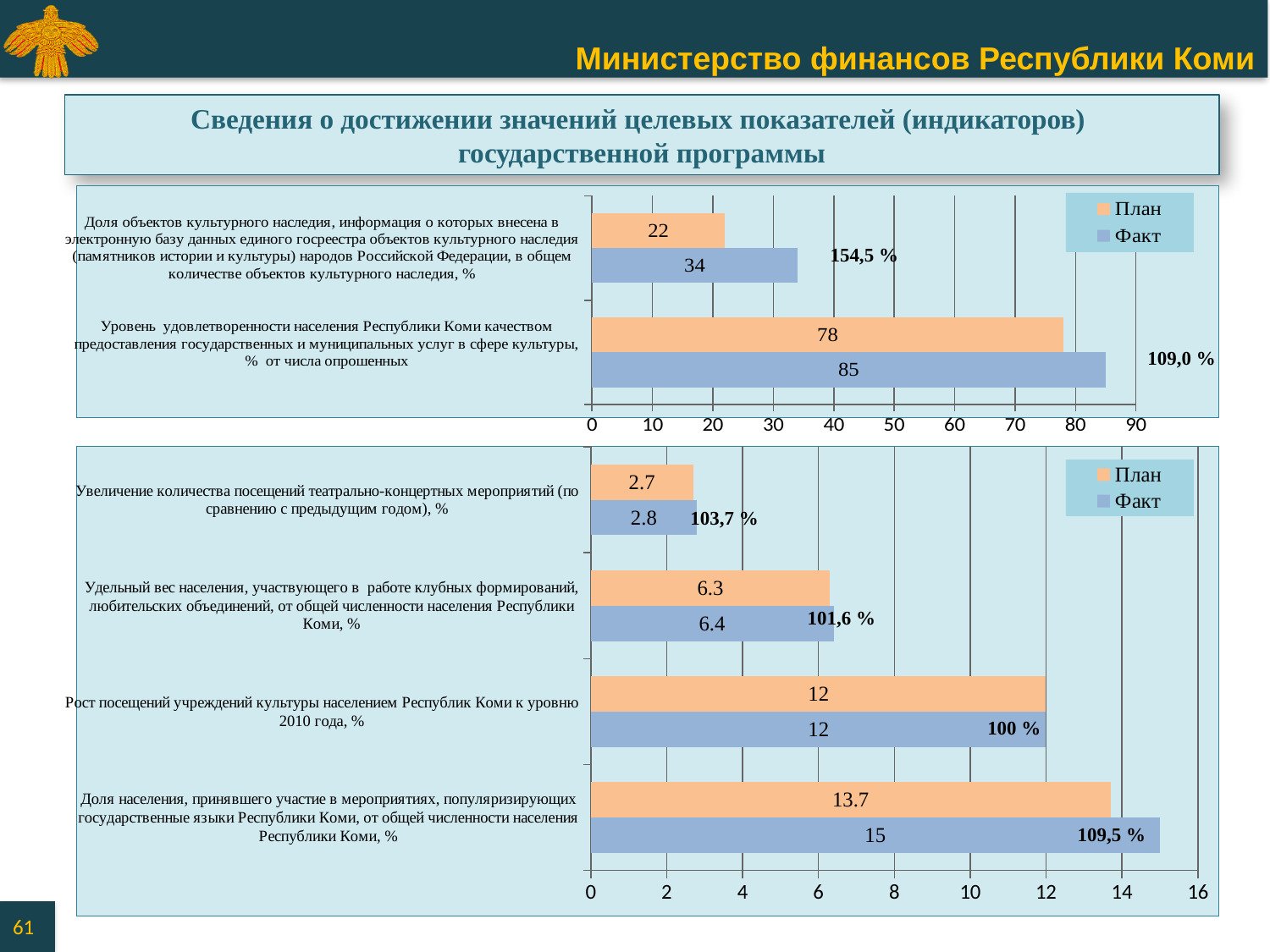
In the bottom chart, how many categories are plotted? 4 In the bottom chart, what is the План value for the increase in attendance of theatre and concert events (Увеличение количества посещений театрально-концертных мероприятий)? 2.7 In the top chart, what is the План value for the share of cultural heritage objects entered in the electronic database (Доля объектов культурного наследия...)? 22 In the bottom chart, what is the difference between the Факт and План values for the share of population participating in events popularizing the state languages (Доля населения, принявшего участие...)? 1.3 In the top chart, what is the difference between the Факт and План values for the level of population satisfaction (Уровень удовлетворенности населения...)? 7 In the top chart, what is the Факт value for the level of population satisfaction with the quality of cultural services (Уровень удовлетворенности населения...)? 85 In the top chart, how many series does the legend list? 2 In the bottom chart, which category has the highest Факт value? Доля населения, принявшего участие в мероприятиях, популяризирующих государственные языки Республики Коми In the top chart, which series is shown in orange according to the legend? План In the bottom chart, what is the Факт value for the share of population participating in events popularizing the state languages of the Republic of Komi (Доля населения, принявшего участие...)? 15 In the bottom chart, which category has the lowest План value? Увеличение количества посещений театрально-концертных мероприятий What kind of chart is the top chart? Bar chart